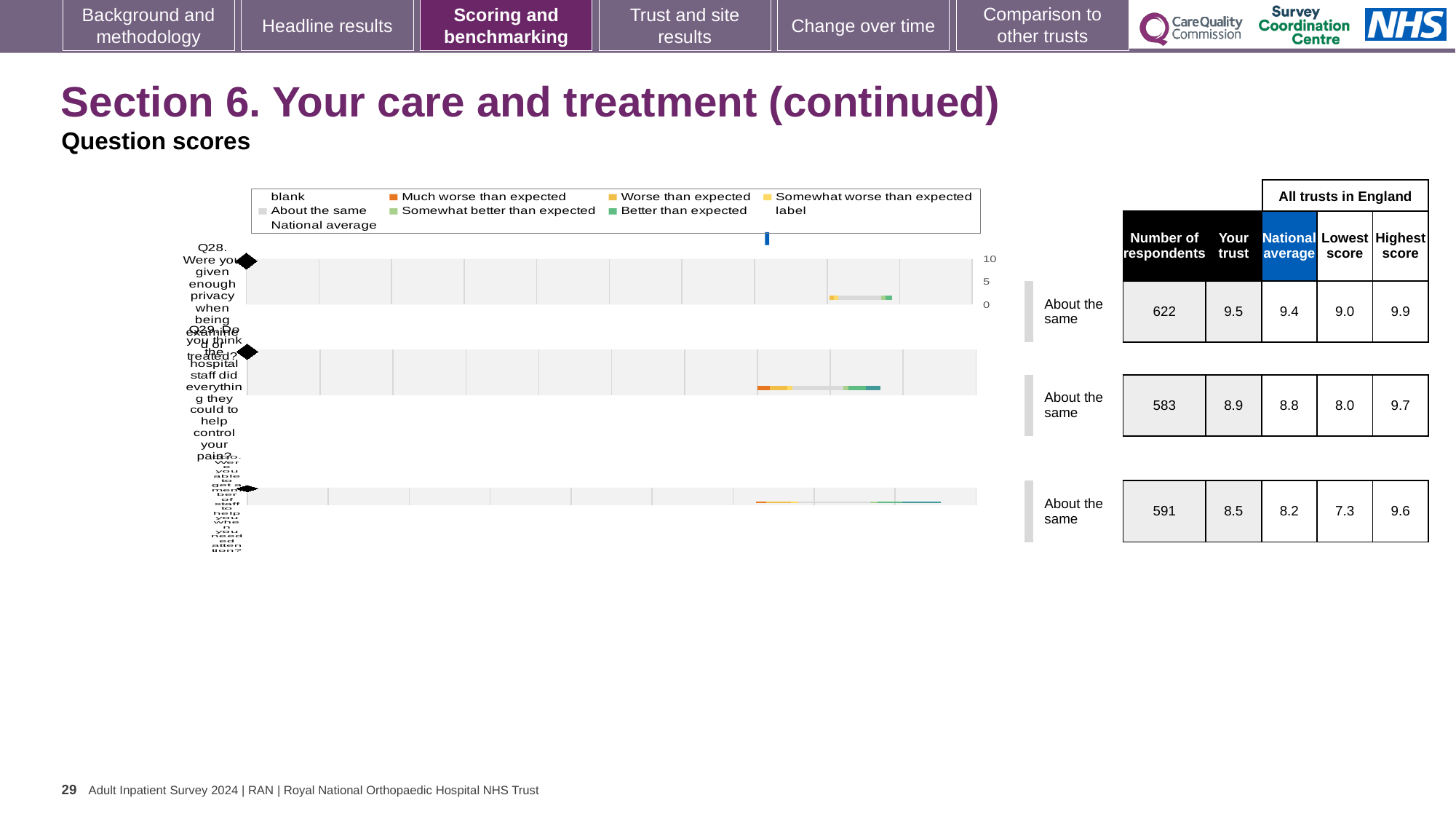
What is the lowest score among all trusts in England for Q30 (getting a member of staff to help when you needed attention)? 7.3 What benchmarking category is shown for Q29? About the same For Q30, which is larger: the 'Your trust' score or the national average? Your trust How many questions are plotted on this slide? 3 Which question on this slide has the highest 'Your trust' score? Q28 How many respondents answered Q29 (Do you think the hospital staff did everything they could to help control your pain?)? 583 What is the difference between the highest and lowest scores for Q30 across all trusts in England? 2.3 What is the 'Your trust' score for Q28 (Were you given enough privacy when being examined or treated?)? 9.5 What is the difference between the 'Your trust' score and the national average for Q29? 0.1 What is the national average score for Q28 (privacy when being examined or treated)? 9.4 What is the highest score among all trusts in England for Q30? 9.6 Which question on this slide has the lowest 'Your trust' score? Q30